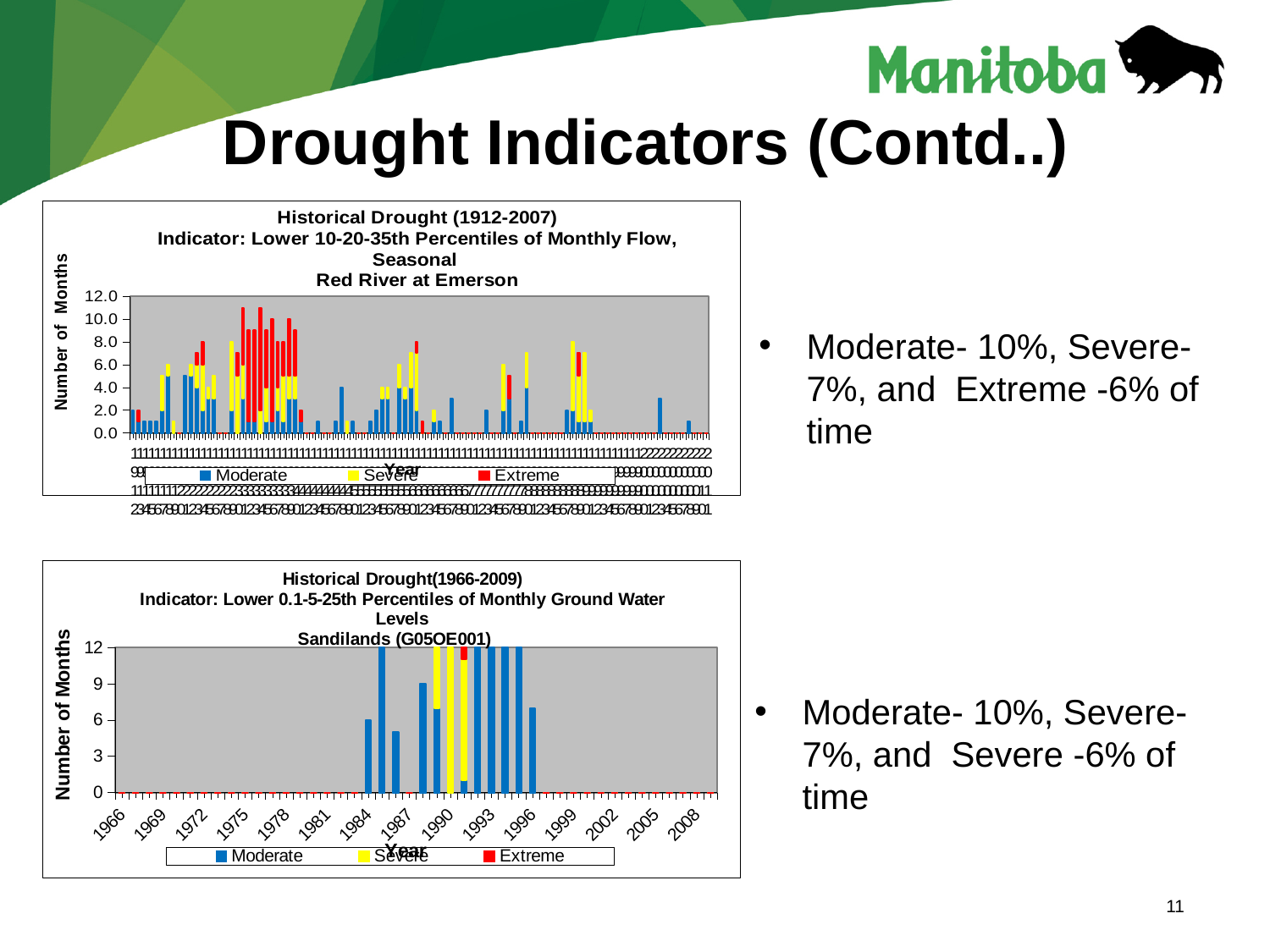
What kind of chart is the bottom chart, 'Historical Drought(1966-2009)' for Sandilands? bar chart How many series does the legend of the bottom chart (Sandilands) list? 3 In the top chart (Red River at Emerson), is the tallest bar greater or less than 10.0? greater What is the y-axis title of the bottom chart (Sandilands)? Number of Months In the bottom chart (Sandilands), is the value for 1984 greater or less than 9? less In the bottom chart (Sandilands), is the value for 1993 greater or less than 9? greater How many series does the legend of the top chart (Red River at Emerson) list? 3 What kind of chart is the top chart, 'Historical Drought (1912-2007)' for the Red River at Emerson? bar chart In the bottom chart (Sandilands), which series is shown in red? Extreme